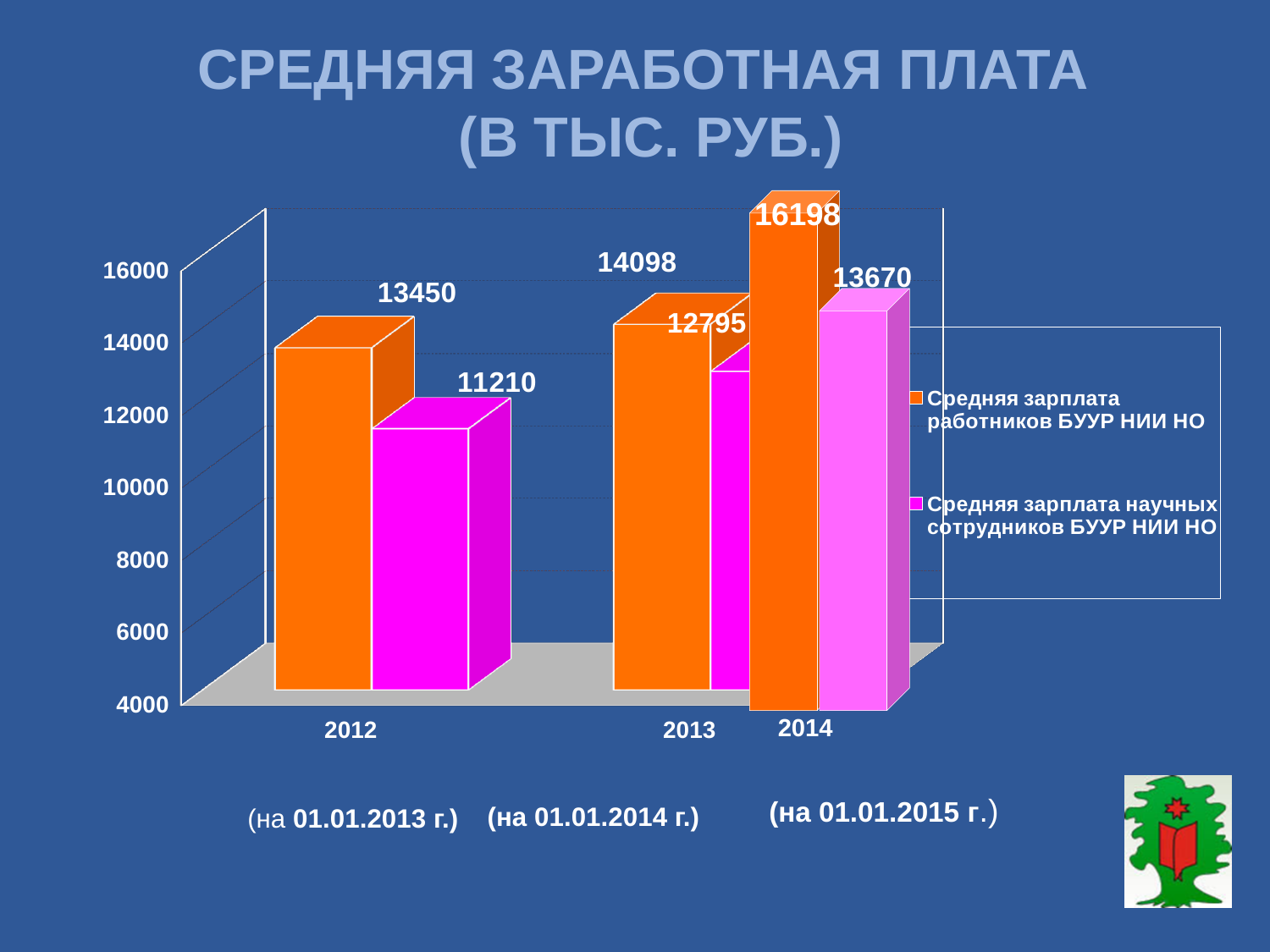
What is the average salary of scientific staff (Средняя зарплата научных сотрудников БУУР НИИ НО) in 2013? 12795 In which year is the average salary of scientific staff (magenta series) lowest? 2012 How many series does the legend list? 2 What is the value of the magenta bar for 2014? 13670 What is the average salary of employees (Средняя зарплата работников БУУР НИИ НО) in 2012? 13450 What is the value of the orange bar for 2014? 16198 Which is larger: the scientific staff salary in 2014 or the employees' salary in 2012? Scientific staff salary in 2014 (13670) How many years (categories) are shown on the x axis? 3 In which year is the average salary of employees (orange series) highest? 2014 Do the values of the orange series rise or fall from 2012 to 2014? Rise What is the difference between the employees' salary and the scientific staff's salary in 2012? 2240 By how much did the average salary of employees (orange series) increase from 2013 to 2014? 2100